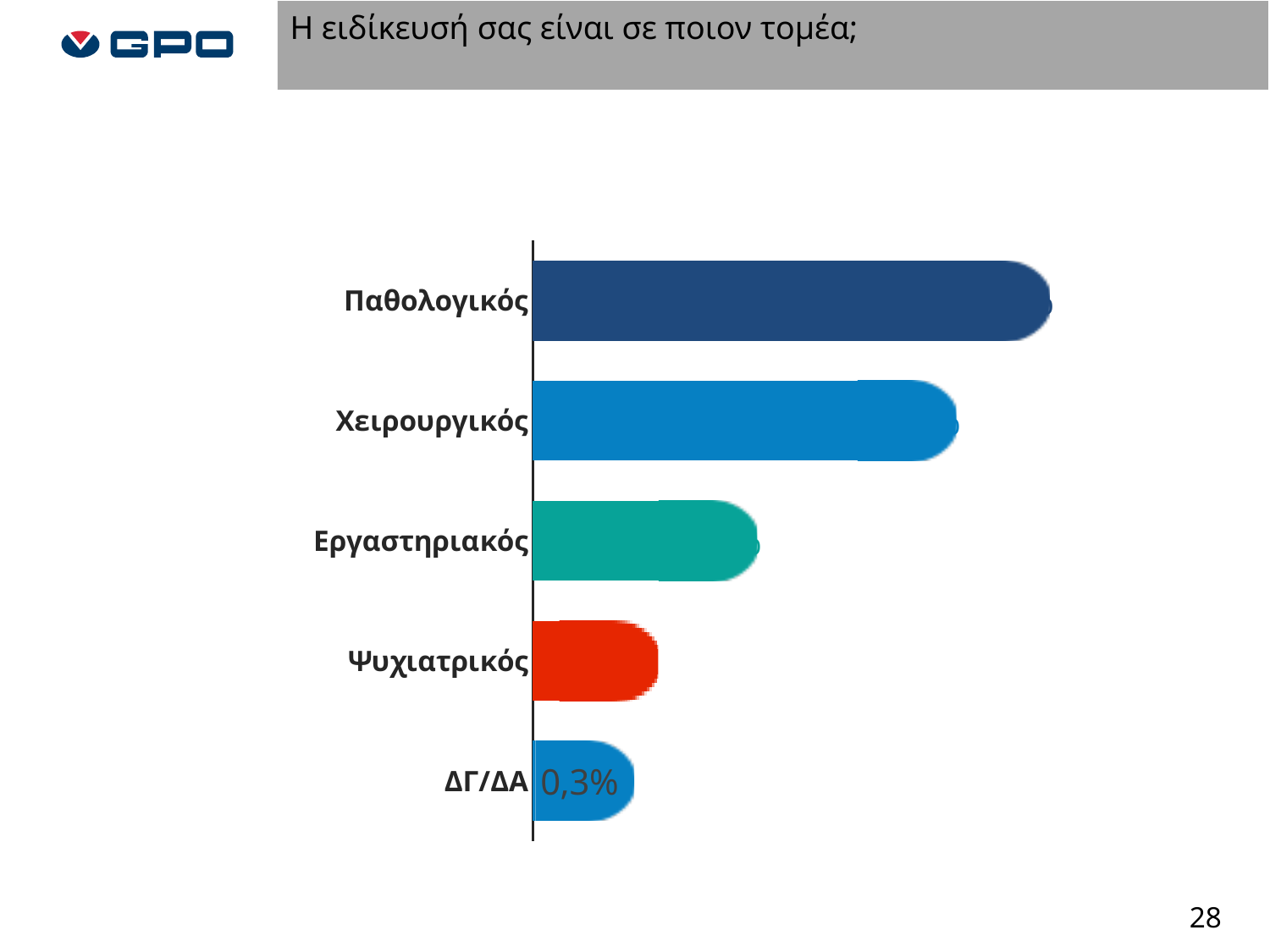
What is the value shown for ΔΓ/ΔΑ? 0,3% Which is larger, the value for Παθολογικός or the value for Χειρουργικός? Παθολογικός What is the question shown as the title of the slide? Η ειδίκευσή σας είναι σε ποιον τομέα; Which is larger, the value for Χειρουργικός or the value for Εργαστηριακός? Χειρουργικός Which category is listed second from the top in the chart? Χειρουργικός What kind of chart is shown on the slide? Bar chart Which category has the shortest bar? ΔΓ/ΔΑ Which is larger, the value for Ψυχιατρικός or the value for ΔΓ/ΔΑ? Ψυχιατρικός Which category has the longest bar? Παθολογικός How many categories are shown in the chart? 5